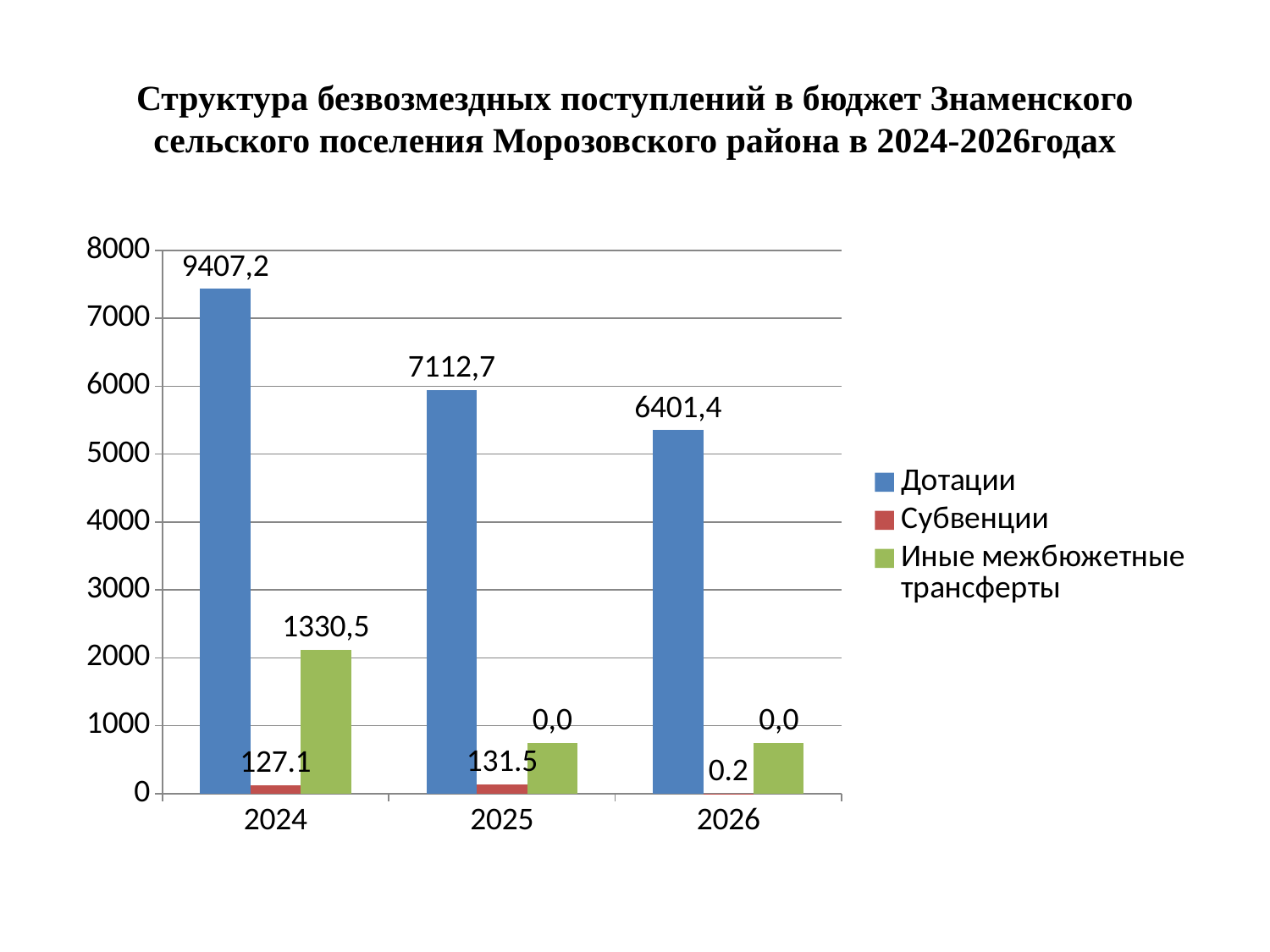
How many series does the legend list? 3 How many years are shown on the x axis? 3 What is the value for Дотации in 2024? 9407,2 What is the value for Иные межбюжетные трансферты in 2024? 1330,5 In which year is the value for Дотации the lowest? 2026 What is the value for Субвенции in 2026? 0.2 What is the value for Дотации in 2026? 6401,4 What is the difference between the Дотации values for 2024 and 2025? 2294,5 Which is larger, the Субвенции value for 2024 or for 2025? 2025 What kind of chart is shown on the slide? Bar chart What is the value for Субвенции in 2025? 131.5 In which year is the value for Дотации the highest? 2024